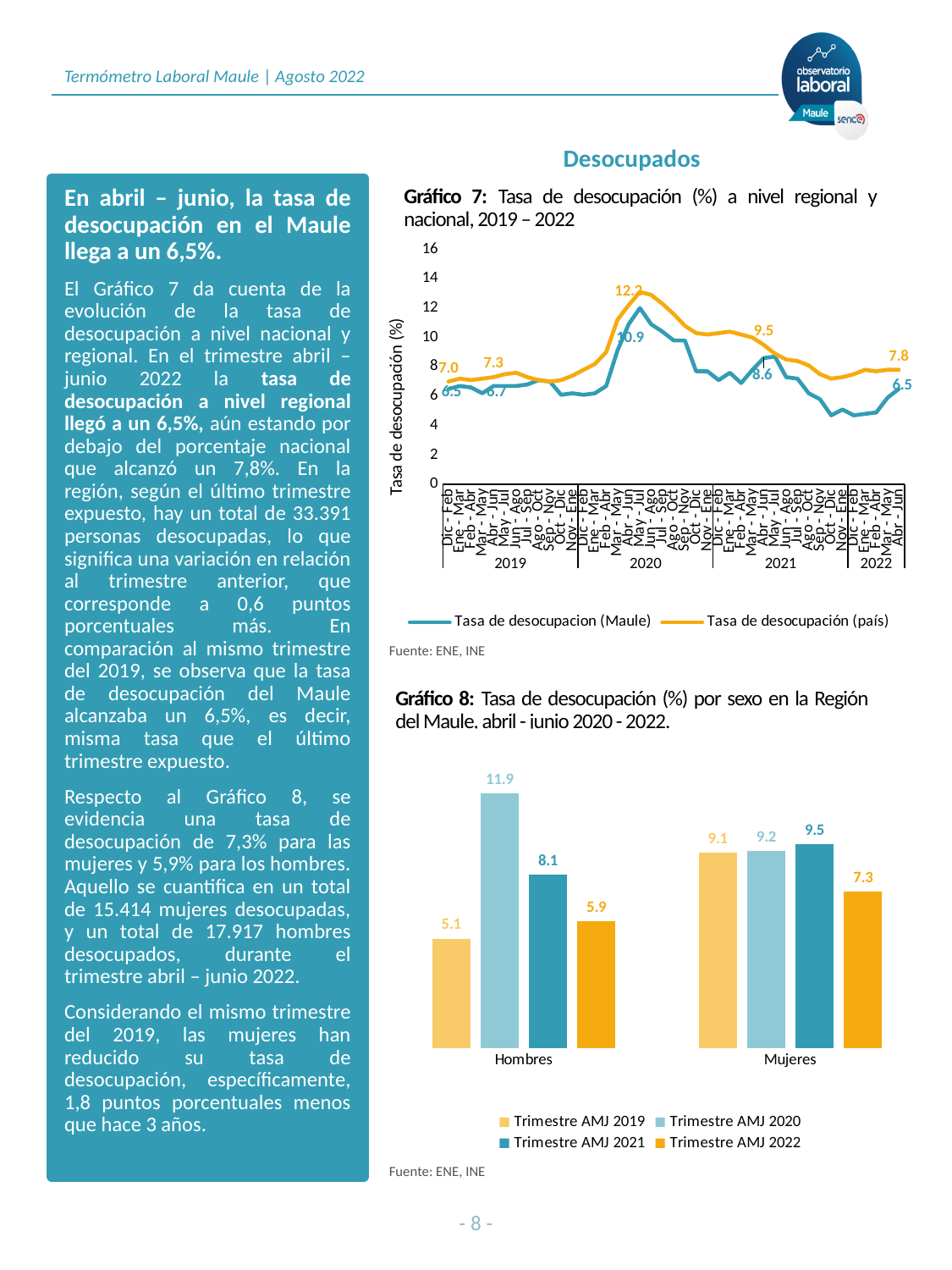
What kind of chart is Gráfico 8? Bar chart In Gráfico 8, what is the unemployment rate for Hombres in Trimestre AMJ 2020? 11.9 In Gráfico 8, what is the difference between the Hombres and Mujeres rates in Trimestre AMJ 2022? 1.4 In Gráfico 7, what is the difference between the país and Maule values at the last point (Abr - Jun 2022)? 1.3 In Gráfico 8, which trimestre has the lowest unemployment rate for Mujeres? Trimestre AMJ 2022 How many series does the legend of Gráfico 8 list? 4 What kind of chart is Gráfico 7? Line chart In Gráfico 7, what is the peak value labelled for the Tasa de desocupación (país) series? 12.2 In Gráfico 8, what is the unemployment rate for Mujeres in Trimestre AMJ 2022? 7.3 In Gráfico 8, which is larger in Trimestre AMJ 2019: the rate for Hombres or for Mujeres? Mujeres In Gráfico 7, what is the value labelled for Tasa de desocupacion (Maule) at Abr - Jun 2022? 6.5 In Gráfico 8, which trimestre has the highest unemployment rate for Hombres? Trimestre AMJ 2020